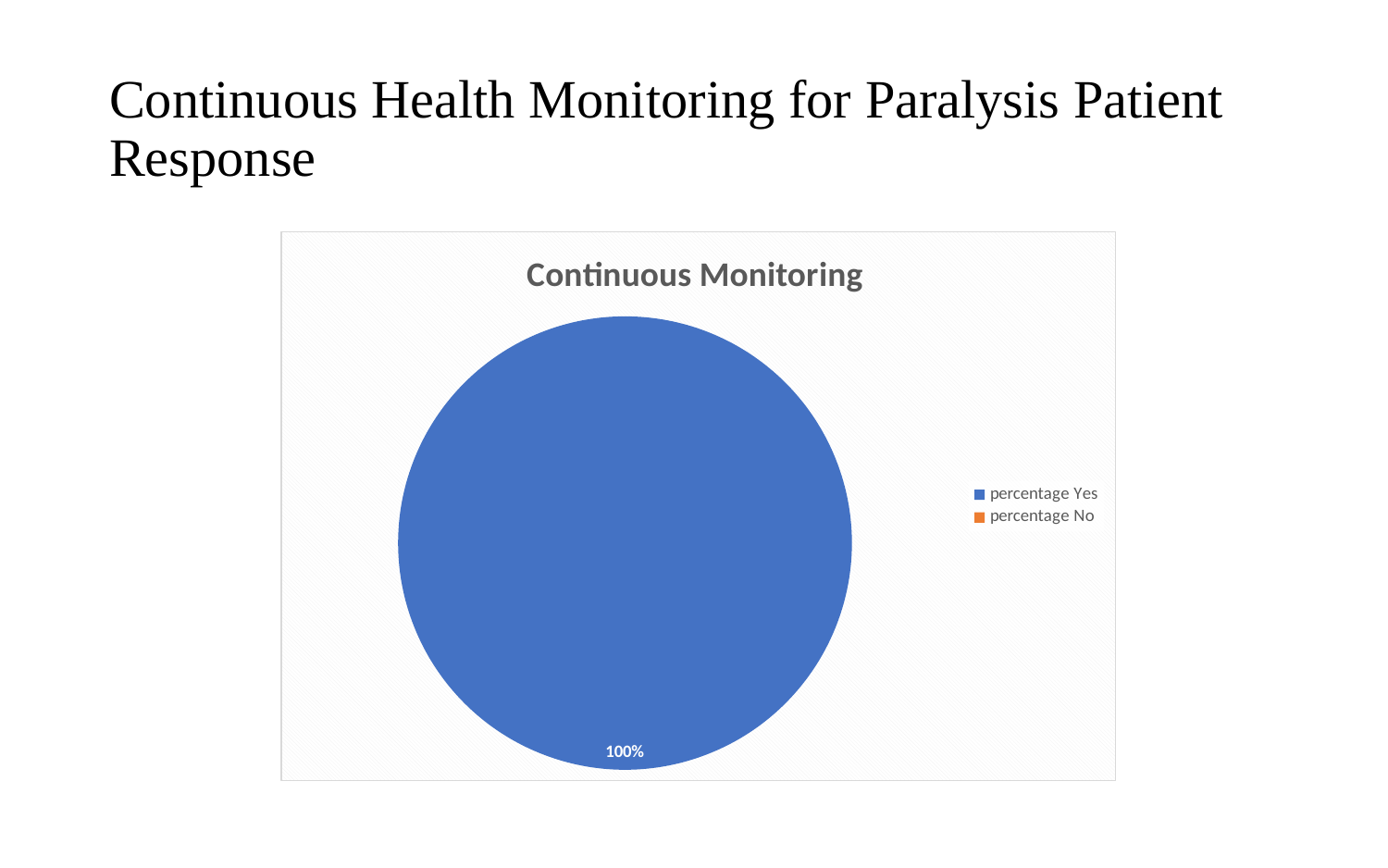
What value is printed on the pie slice? 100% How many slices are visible in the pie? 1 What kind of chart is shown on the slide? pie chart How many entries does the chart legend list? 2 What share of the pie does "percentage Yes" take? 100% What is the title of the chart? Continuous Monitoring Which legend category makes up the largest share of the pie? percentage Yes Which legend category has the smallest share of the pie? percentage No Which is larger, the share for "percentage Yes" or "percentage No"? percentage Yes What colour is the "percentage Yes" slice? blue